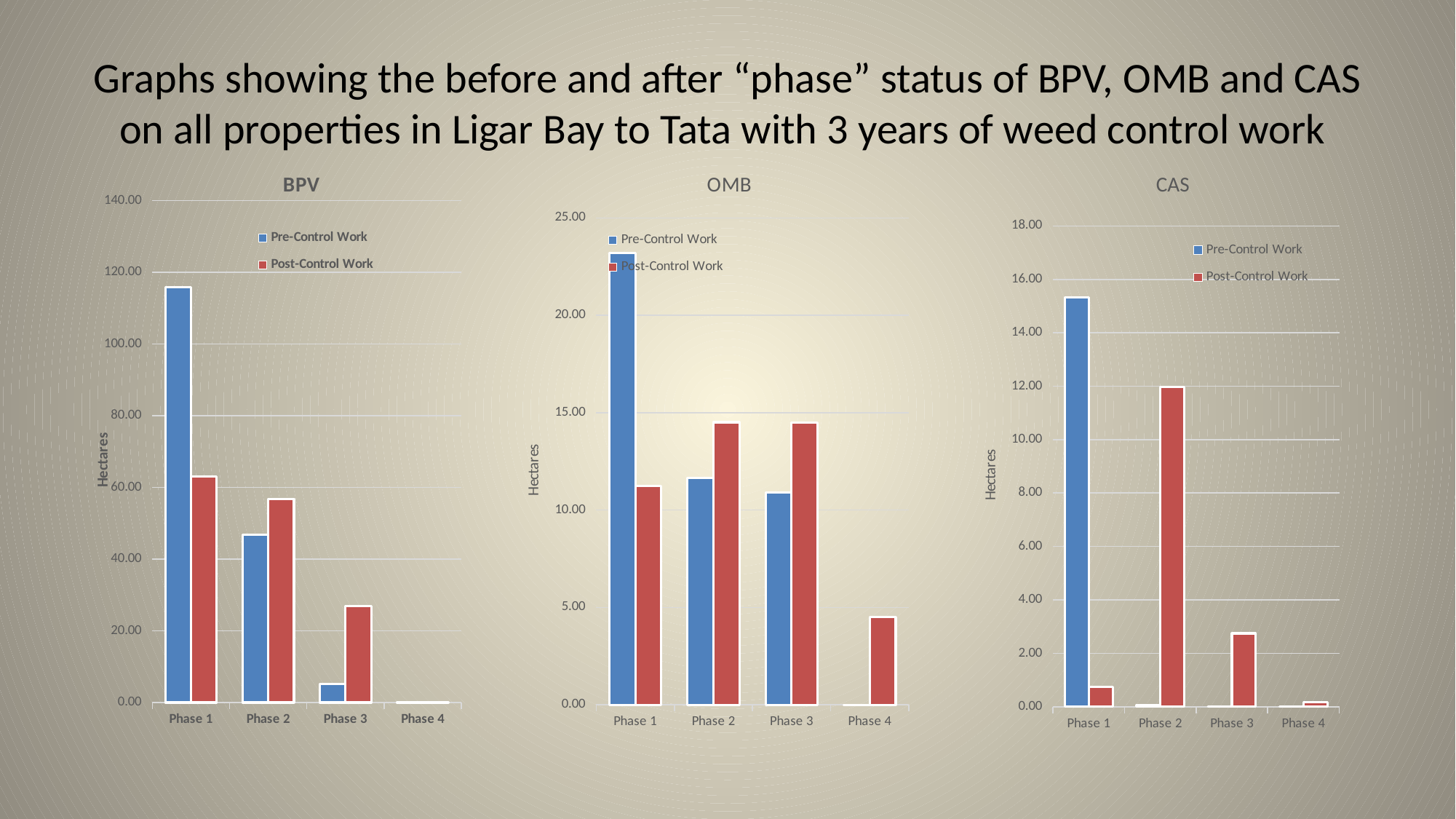
In the BPV chart, for Phase 2, which is larger: Pre-Control Work or Post-Control Work? Post-Control Work How many series does the legend of the OMB chart list? 2 How many phases are shown on the x axis of the CAS chart? 4 In the CAS chart, is the Pre-Control Work value for Phase 1 greater or less than 14.00? greater In the BPV chart, which phase has the highest Pre-Control Work value? Phase 1 In the OMB chart, is the Post-Control Work value for Phase 4 greater or less than 5.00? less What is the y-axis label on the CAS chart? Hectares What kind of chart is the BPV chart? bar chart In the OMB chart, is the Pre-Control Work value for Phase 1 greater or less than 20.00? greater In the CAS chart, which phase has the highest Post-Control Work value? Phase 2